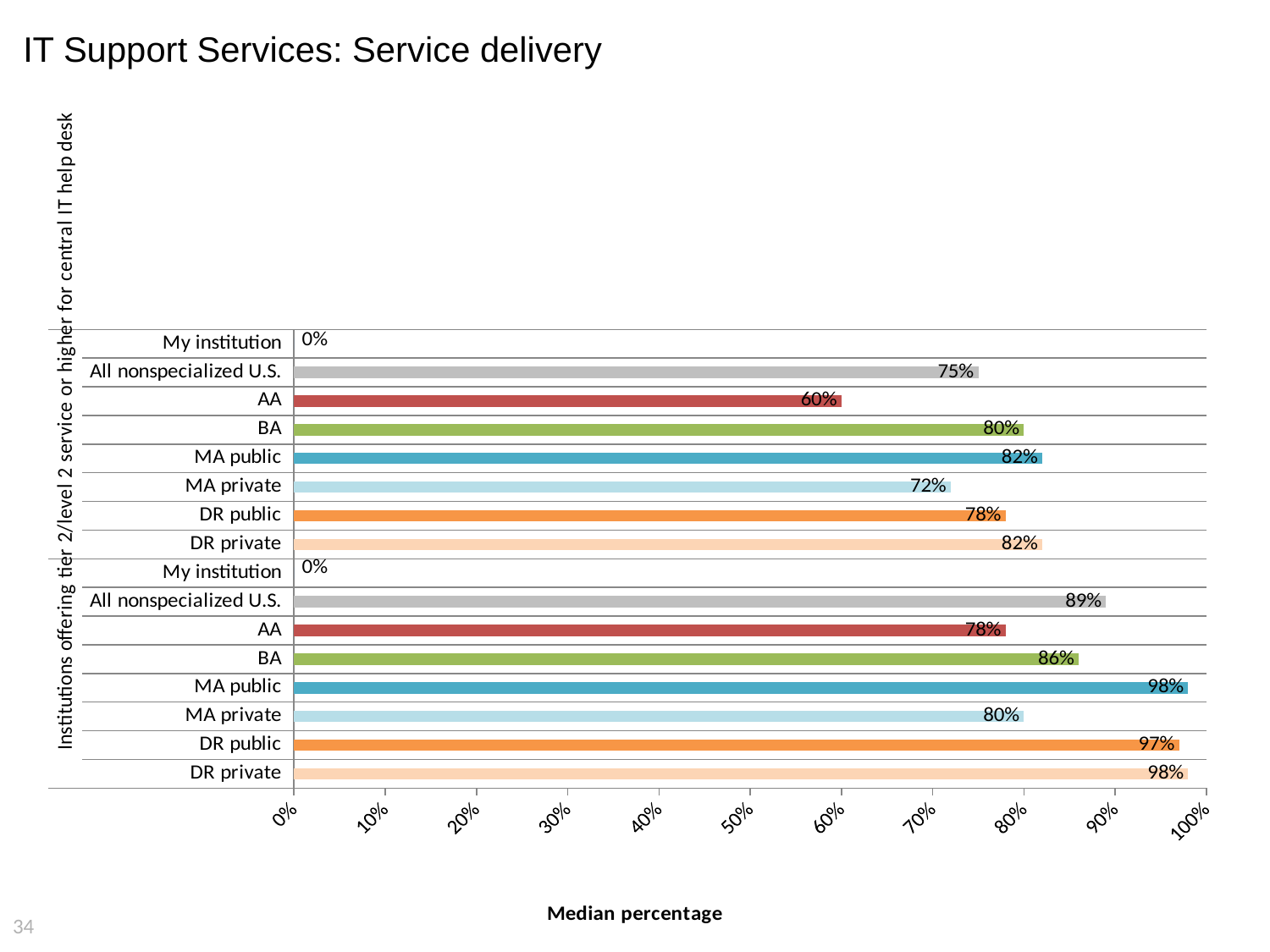
In the lower group of bars, what is the value for DR public? 97% In the lower group of bars, what is the value for All nonspecialized U.S.? 89% In the upper group of bars, which category has the lowest non-zero value? AA In the upper group of bars, what is the value for MA private? 72% In the upper group of bars, what is the value for AA? 60% In the upper group of bars, which is larger, DR public or All nonspecialized U.S.? DR public In the lower group of bars, which category has the lowest value? My institution In the lower group of bars, is the value for BA greater or less than 80%? greater How many bars are plotted in total on the chart? 16 What kind of chart is shown on the slide? Bar chart In the upper group of bars, what is the difference between BA and AA? 20% In the lower group of bars, what is the difference between MA public and MA private? 18%